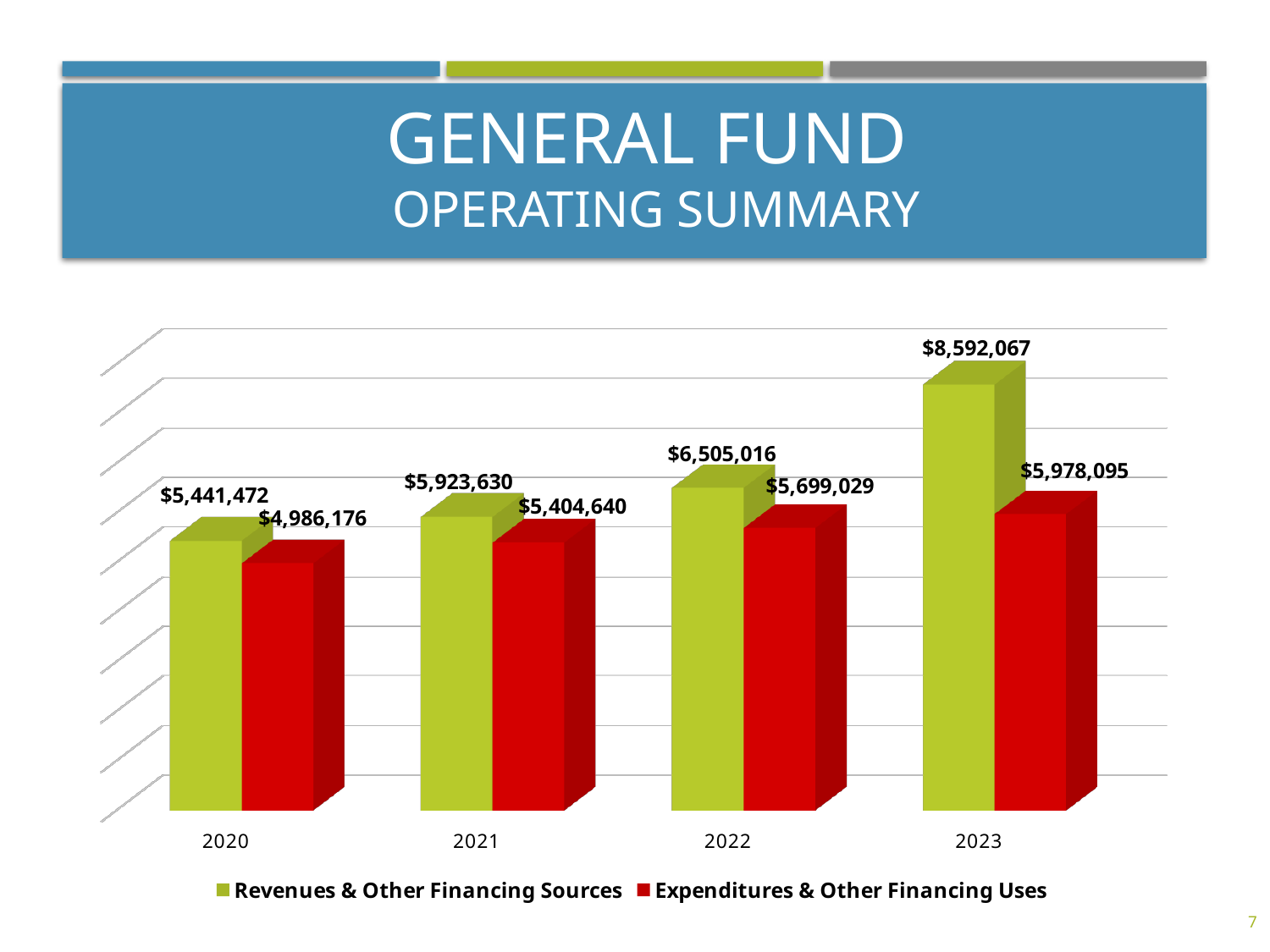
What is the difference between Revenues & Other Financing Sources in 2023 and in 2022? $2,087,051 What is the value for Revenues & Other Financing Sources in 2021? $5,923,630 Which year has the lowest value for Expenditures & Other Financing Uses? 2020 How many series does the legend list? 2 What is the value for Expenditures & Other Financing Uses in 2022? $5,699,029 How many years are shown on the x axis of the chart? 4 Do the values for Revenues & Other Financing Sources rise or fall from 2020 to 2023? rise What is the value for Revenues & Other Financing Sources in 2023? $8,592,067 In 2021, which is larger: Revenues & Other Financing Sources or Expenditures & Other Financing Uses? Revenues & Other Financing Sources What is the difference between Revenues & Other Financing Sources and Expenditures & Other Financing Uses in 2023? $2,613,972 Which year has the highest value for Revenues & Other Financing Sources? 2023 What is the value for Expenditures & Other Financing Uses in 2020? $4,986,176